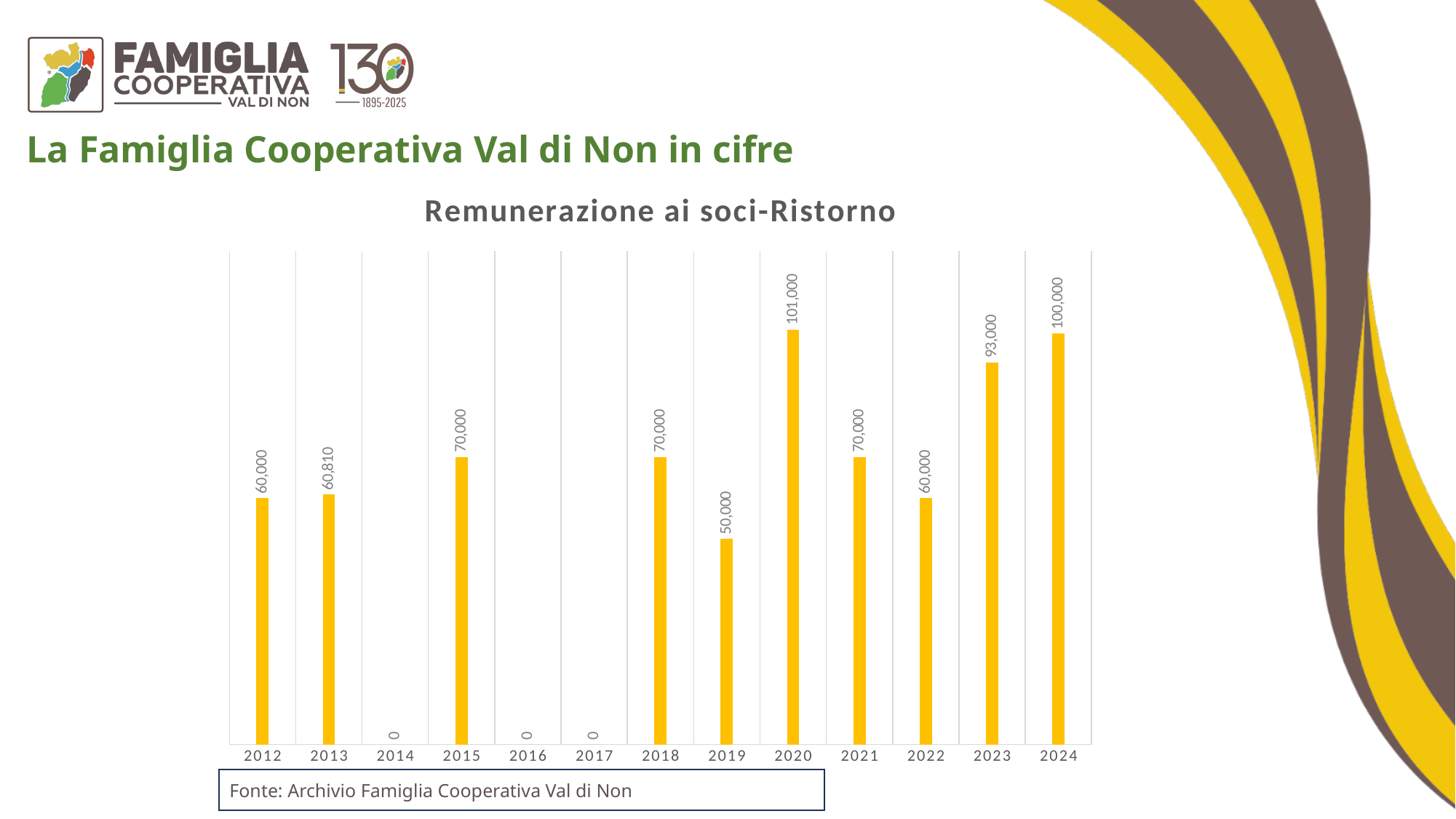
What is the value for 2023? 93,000 What kind of chart is shown? Bar chart What is the title of the chart? Remunerazione ai soci-Ristorno What is the value for 2019? 50,000 What is the difference between the values for 2024 and 2023? 7,000 Which year has the highest value? 2020 How many years have a value of 0? 3 What is the difference between the values for 2013 and 2012? 810 What is the value for 2013? 60,810 What is the value for 2020? 101,000 Which is larger, the value for 2021 or the value for 2022? 2021 How many years are shown on the x axis? 13